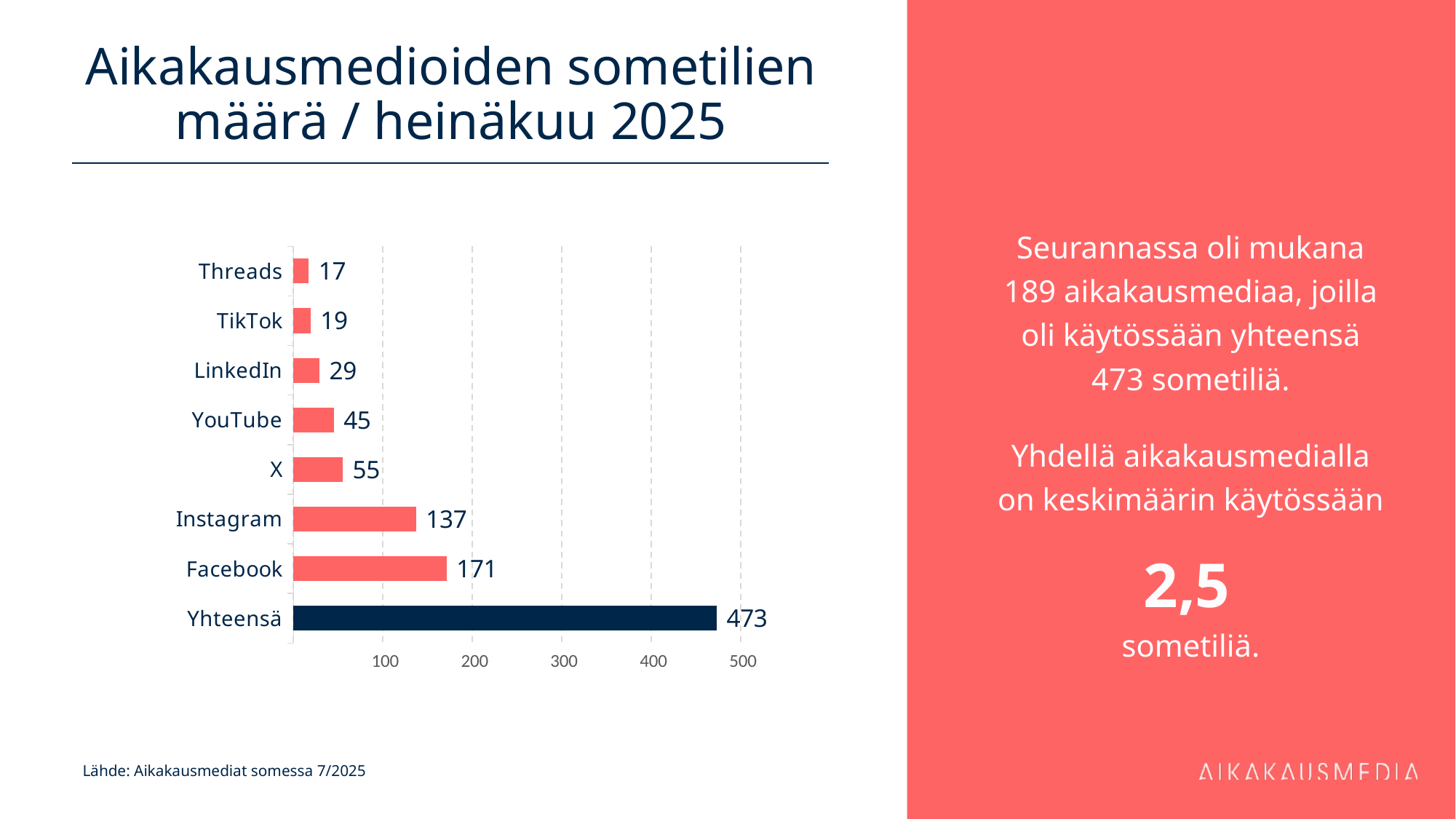
How many bars are shown in the chart, including the Yhteensä bar? 8 What is the difference between the values for X and YouTube? 10 Which platform has the lowest value? Threads What is the value for Facebook? 171 What is the difference between the values for Facebook and Instagram? 34 What is the value shown for Yhteensä? 473 What is the value for LinkedIn? 29 What kind of chart is shown on the slide? Bar chart Excluding the Yhteensä total bar, which platform has the highest value? Facebook What is the value for Instagram? 137 Which has a larger value, TikTok or LinkedIn? LinkedIn Which bar is shown in a different (dark navy) colour from the others? Yhteensä